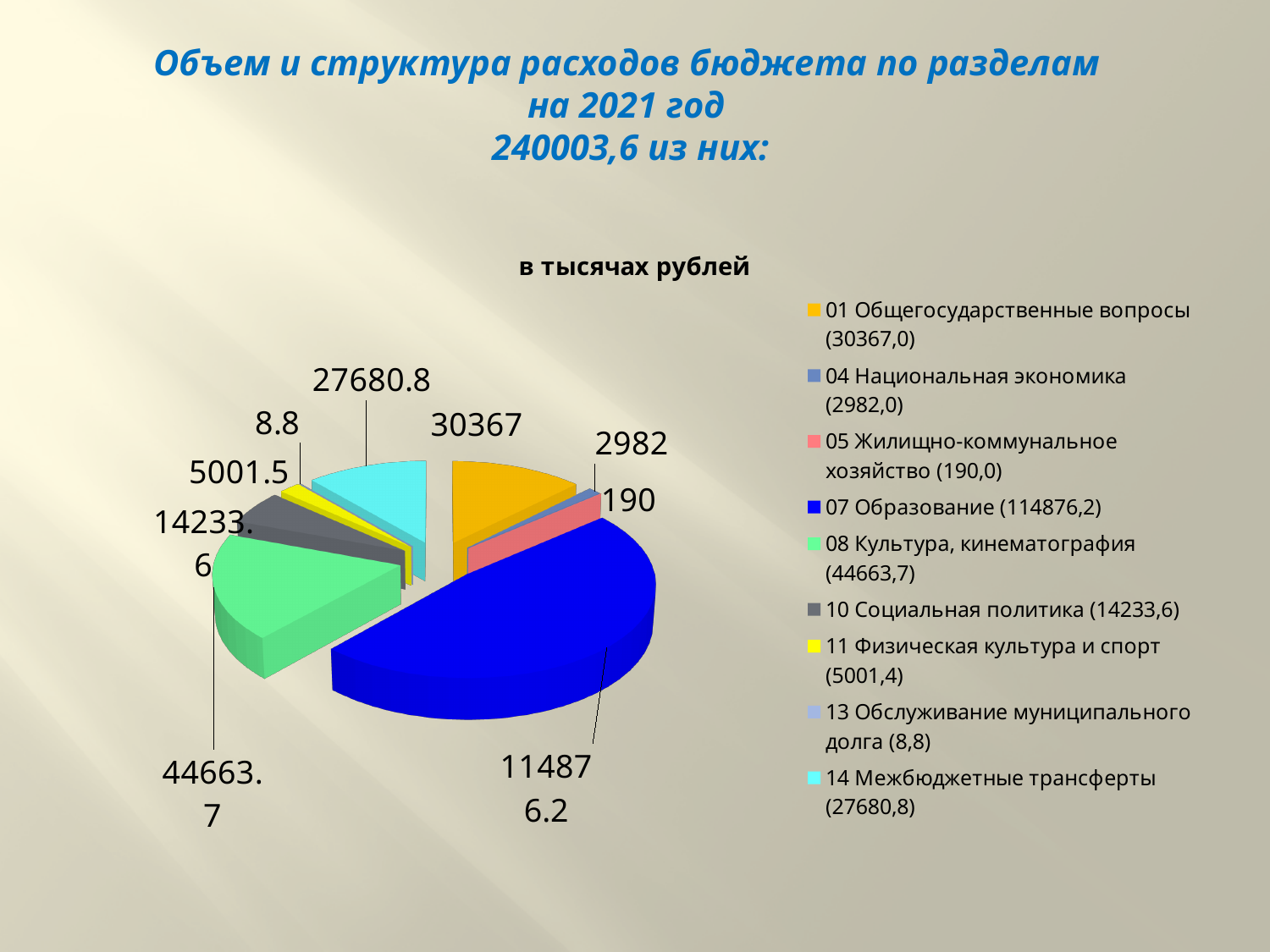
What is the value shown for 05 Жилищно-коммунальное хозяйство in the pie chart? 190 What is the value shown for 14 Межбюджетные трансферты in the pie chart? 27680.8 How many categories does the legend of the pie chart list? 9 What is the difference between the values for 01 Общегосударственные вопросы and 04 Национальная экономика? 27385 What is the difference between the values for 08 Культура, кинематография and 14 Межбюджетные трансферты? 16982.9 What is the value shown for 07 Образование in the pie chart? 114876.2 Which is larger in the pie chart: 08 Культура, кинематография or 01 Общегосударственные вопросы? 08 Культура, кинематография What kind of chart is shown on the slide? pie chart What is the value shown for 01 Общегосударственные вопросы in the pie chart? 30367 Which category has the smallest value in the pie chart? 13 Обслуживание муниципального долга What is the title printed above the pie chart? в тысячах рублей Which category has the largest slice in the pie chart? 07 Образование